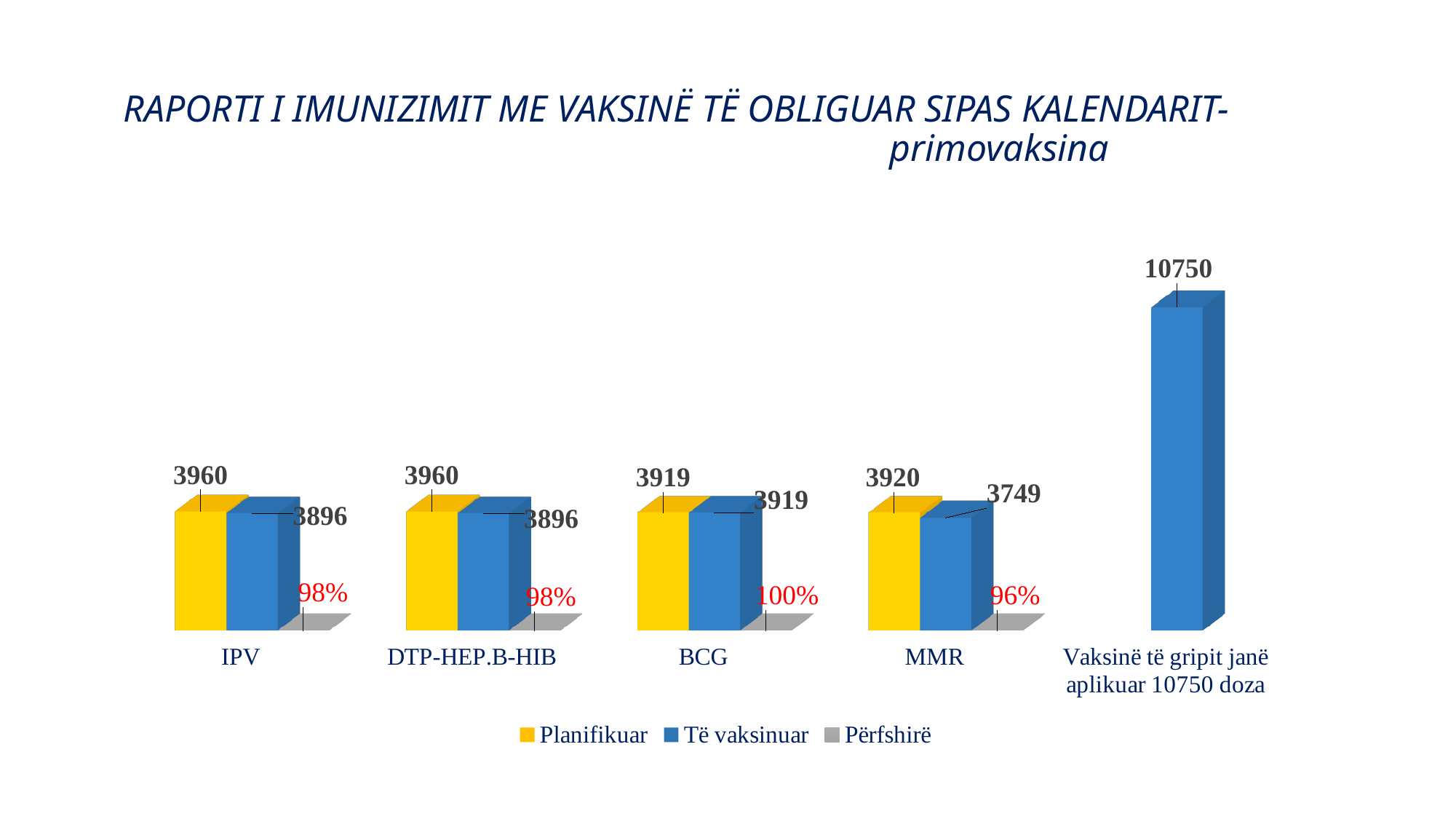
Among IPV, DTP-HEP.B-HIB, BCG and MMR, which has the lowest Të vaksinuar value? MMR What is the Përfshirë percentage shown for MMR? 96% What is the Të vaksinuar value for BCG? 3919 What is the value labelled on the bar for 'Vaksinë të gripit janë aplikuar 10750 doza'? 10750 What is the Planifikuar value for IPV? 3960 Which is larger, the Planifikuar value for BCG or the Planifikuar value for MMR? MMR What is the difference between the Planifikuar and Të vaksinuar values for MMR? 171 How many series does the legend list? 3 What kind of chart is shown on the slide? Bar chart What is the difference between the Planifikuar and Të vaksinuar values for IPV? 64 What is the Të vaksinuar value for MMR? 3749 Which category has the highest Të vaksinuar value? Vaksinë të gripit janë aplikuar 10750 doza